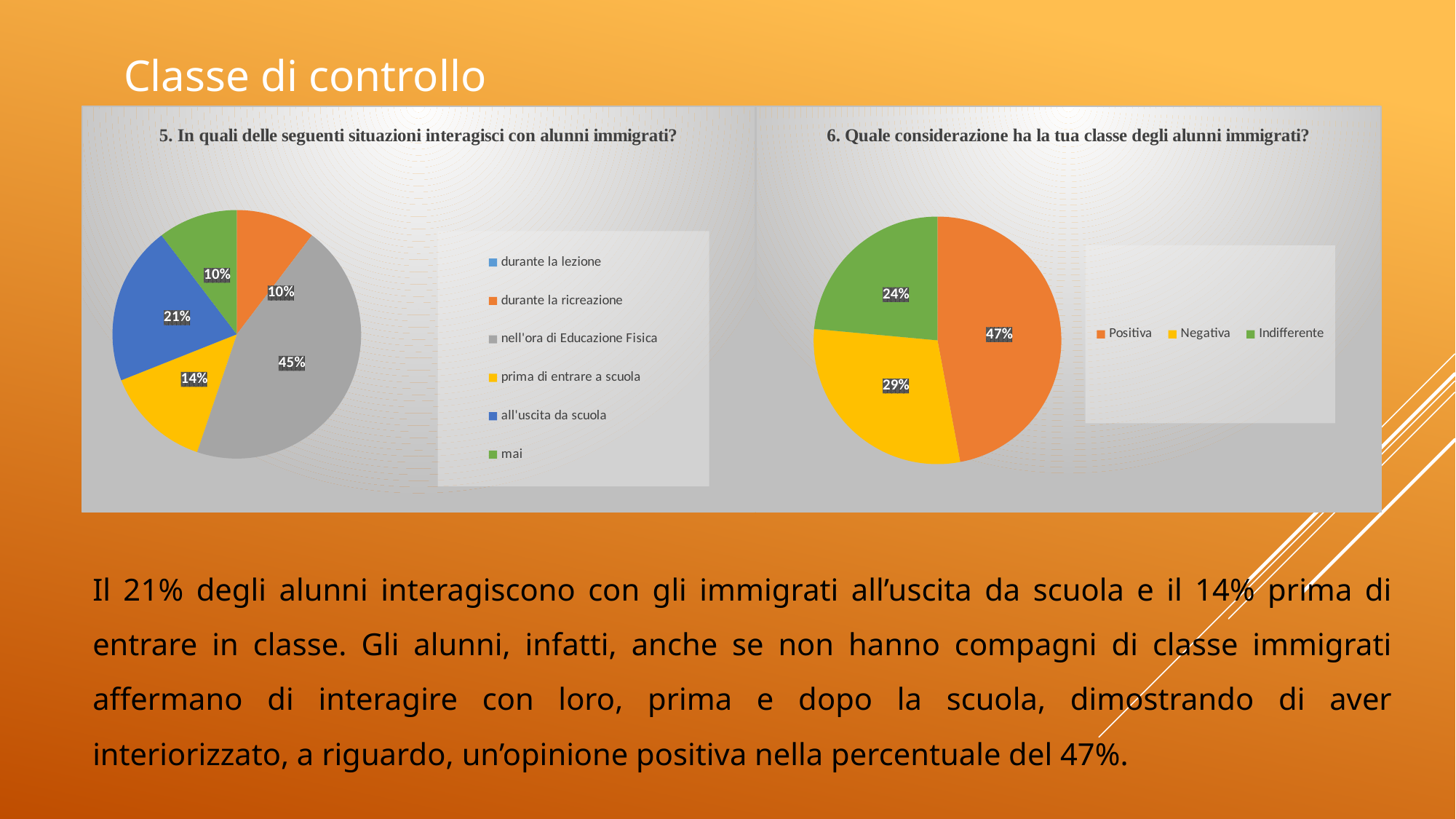
In the chart titled "6. Quale considerazione ha la tua classe degli alunni immigrati?", what is the difference between the "Positiva" and "Negativa" slices? 18% In the chart titled "5. In quali delle seguenti situazioni interagisci con alunni immigrati?", which category has the largest slice? nell'ora di Educazione Fisica In the chart titled "5. In quali delle seguenti situazioni interagisci con alunni immigrati?", how many entries does the legend list? 6 In the chart titled "6. Quale considerazione ha la tua classe degli alunni immigrati?", which is larger, "Negativa" or "Indifferente"? Negativa In the chart titled "6. Quale considerazione ha la tua classe degli alunni immigrati?", what percentage is shown for "Positiva"? 47% In the chart titled "5. In quali delle seguenti situazioni interagisci con alunni immigrati?", what percentage is shown for "all'uscita da scuola"? 21% In the chart titled "6. Quale considerazione ha la tua classe degli alunni immigrati?", which category has the smallest slice? Indifferente In the chart titled "5. In quali delle seguenti situazioni interagisci con alunni immigrati?", what percentage is shown for "nell'ora di Educazione Fisica"? 45% In the chart titled "5. In quali delle seguenti situazioni interagisci con alunni immigrati?", what percentage is shown for "prima di entrare a scuola"? 14% What type of chart is the one titled "6. Quale considerazione ha la tua classe degli alunni immigrati?"? pie chart In the chart titled "5. In quali delle seguenti situazioni interagisci con alunni immigrati?", what is the difference between the "all'uscita da scuola" and "prima di entrare a scuola" slices? 7% In the chart titled "6. Quale considerazione ha la tua classe degli alunni immigrati?", what percentage is shown for "Indifferente"? 24%